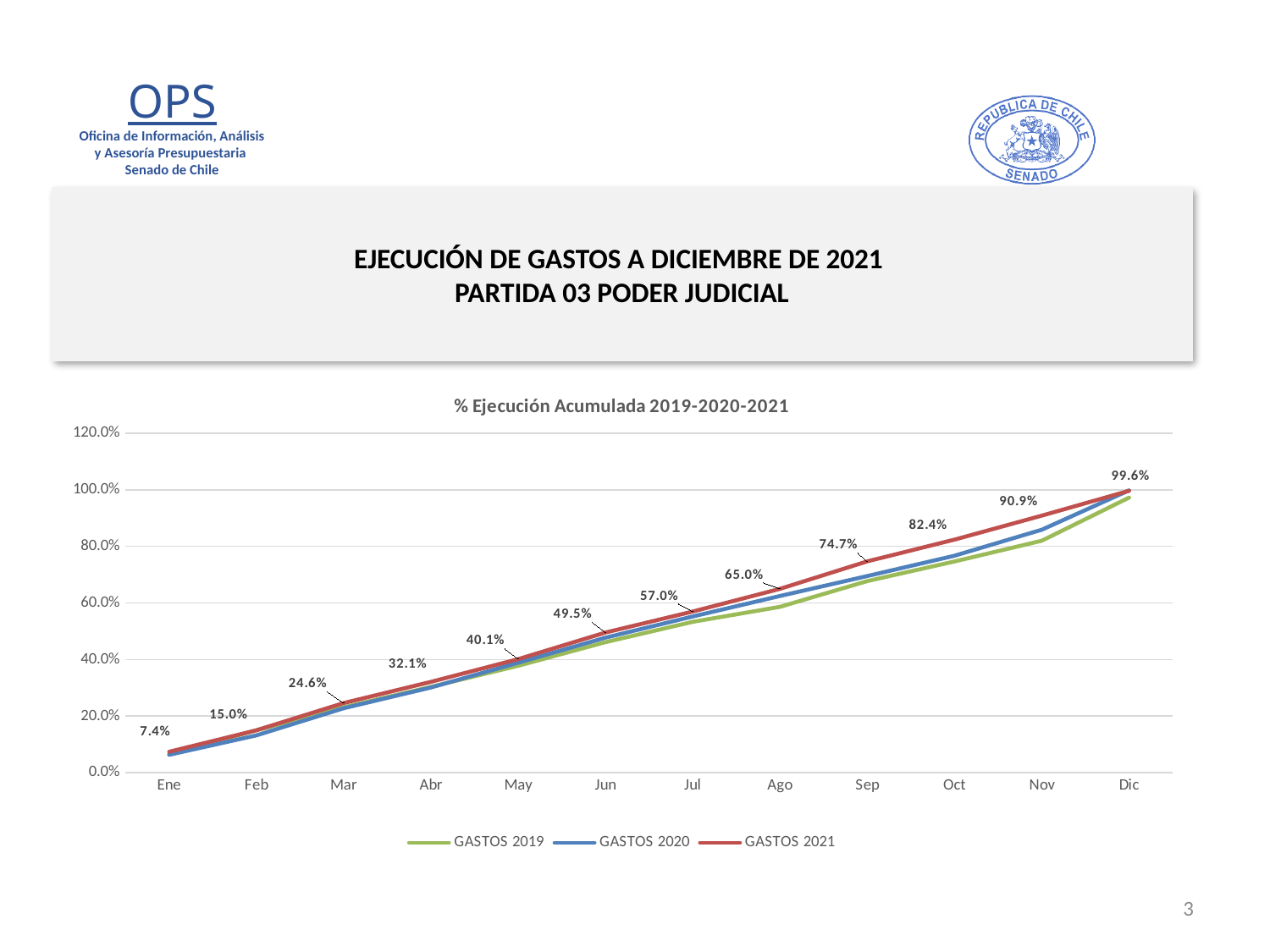
What is the value for GASTOS 2021 in Sep? 74.7% Is the value for GASTOS 2019 in Dic greater or less than 80.0%? greater What type of chart is shown on the slide? line chart What is the value for GASTOS 2021 in Dic? 99.6% How many months are shown on the x axis? 12 In Nov, which series has the higher value, GASTOS 2021 or GASTOS 2019? GASTOS 2021 What is the difference between the GASTOS 2021 values for Nov and Oct? 8.5% How many series does the legend list? 3 What is the title of the chart? % Ejecución Acumulada 2019-2020-2021 Do the GASTOS 2021 values rise or fall from Ene to Dic? rise What is the value for GASTOS 2021 in Ene? 7.4% What is the value for GASTOS 2021 in Jun? 49.5%